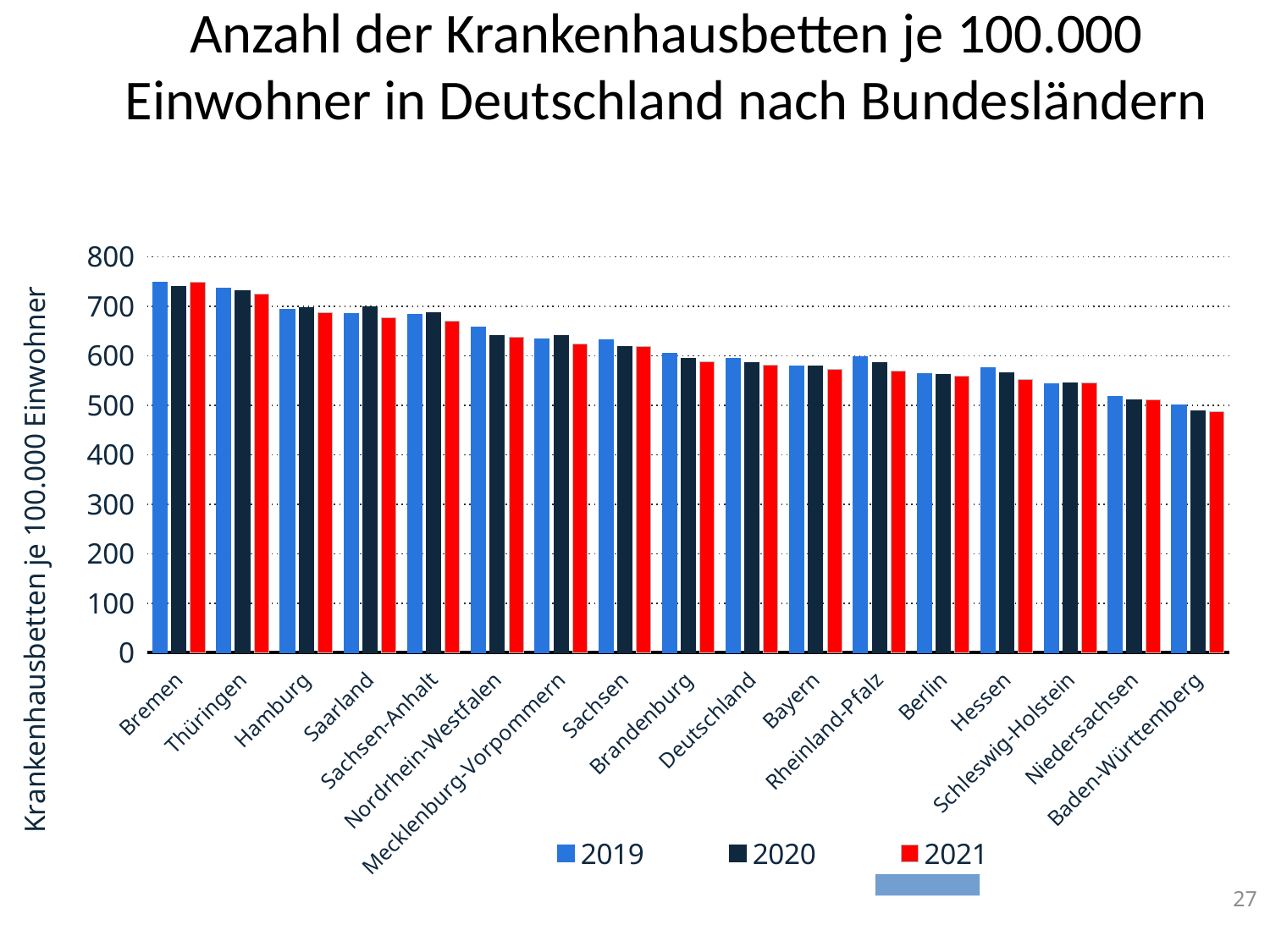
What is the label of the y axis? Krankenhausbetten je 100.000 Einwohner How many Bundesländer/categories are shown on the x axis? 17 Is the 2019 value for Sachsen greater or less than 600? greater Which category has the highest value for 2019? Bremen Is the 2019 value for Bremen greater or less than 700? greater Is the 2021 value for Hessen greater or less than 600? less How many series does the legend list? 3 What kind of chart is shown on the slide? bar chart Which category has the lowest value for 2021? Baden-Württemberg Which is larger, the 2021 value for Thüringen or the 2021 value for Hessen? Thüringen Do the values generally rise or fall moving from left to right along the x axis? fall